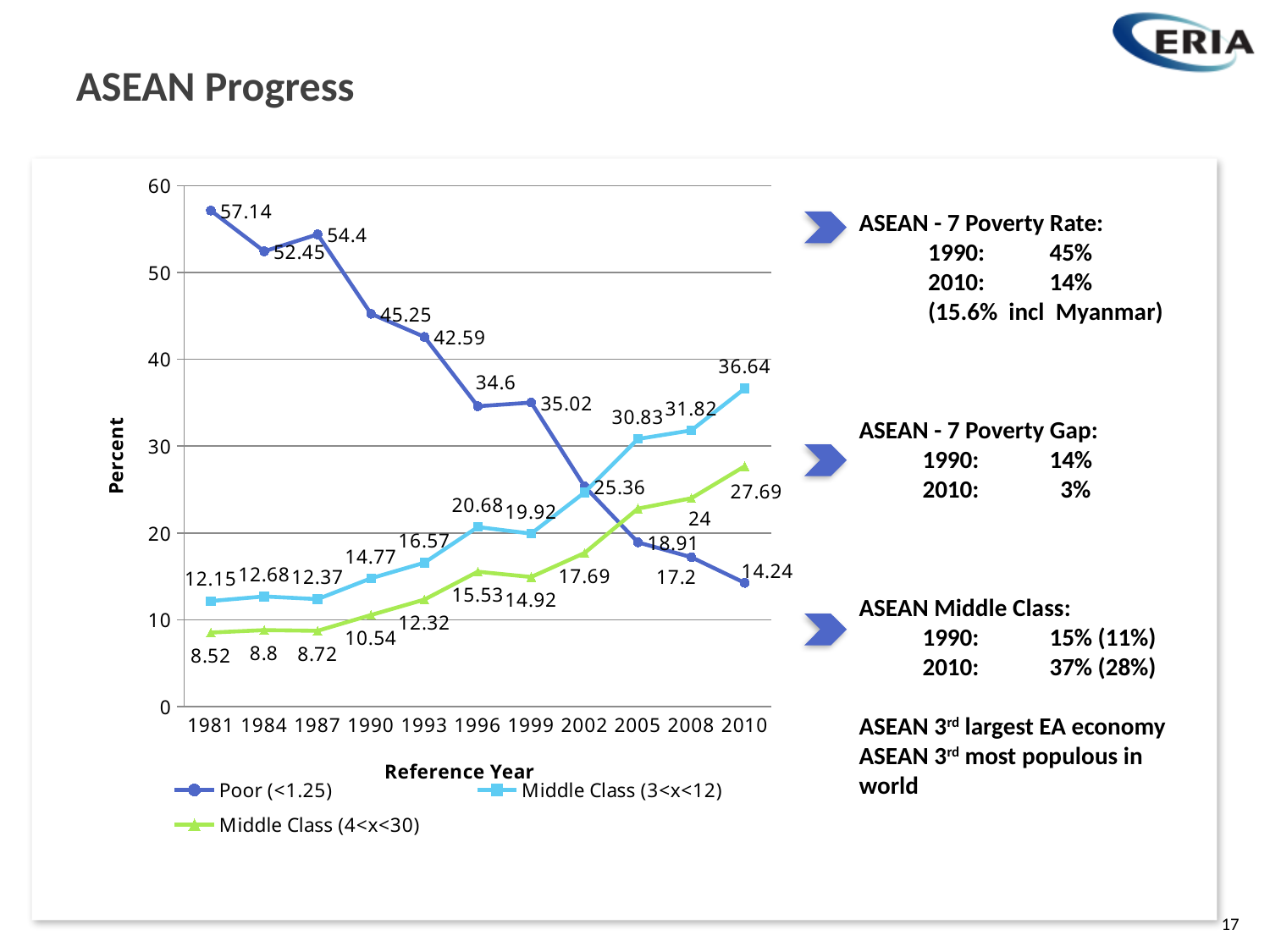
How many reference years are plotted along the x axis? 11 In 2010, which series has the larger value: Middle Class (3<x<12) or Middle Class (4<x<30)? Middle Class (3<x<12) What is the value of the Poor (<1.25) series in 2010? 14.24 In which year is the Poor (<1.25) series at its highest? 1981 What kind of chart is shown on the slide? line chart Does the Poor (<1.25) series generally rise or fall from 1981 to 2010? fall How many series does the chart legend list? 3 What is the value of the Middle Class (3<x<12) series in 2010? 36.64 What is the value of the Poor (<1.25) series in 1981? 57.14 By how much did the Poor (<1.25) value decrease from 1981 to 2010? 42.9 What is the title of the x axis? Reference Year What is the value of the Middle Class (4<x<30) series in 1981? 8.52